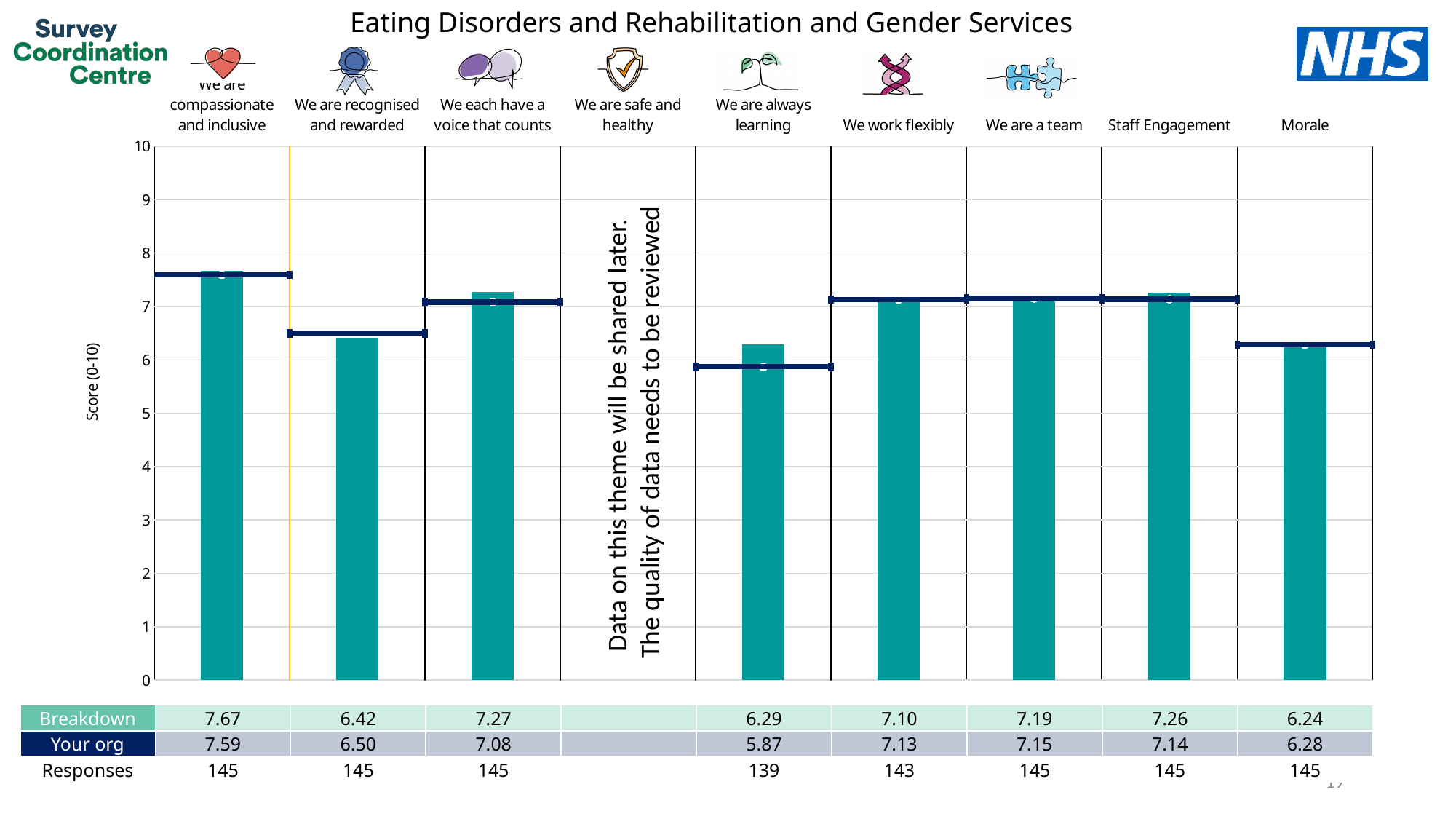
Which theme has the lowest Breakdown score? Morale Is the Breakdown score for 'Staff Engagement' greater or less than 7? greater What is the title of the chart? Eating Disorders and Rehabilitation and Gender Services What is the Your org score for 'We are always learning'? 5.87 How many themes have a bar plotted on the chart? 8 What is the difference between the Breakdown and Your org scores for 'We are always learning'? 0.42 How many responses are recorded for 'We work flexibly'? 143 What kind of chart is shown on the slide? Bar chart Which theme has the highest Breakdown score? We are compassionate and inclusive Which is larger for 'We are recognised and rewarded': the Breakdown score or the Your org score? Your org Which theme has the lowest Your org score? We are always learning What is the Breakdown score for 'We are compassionate and inclusive'? 7.67